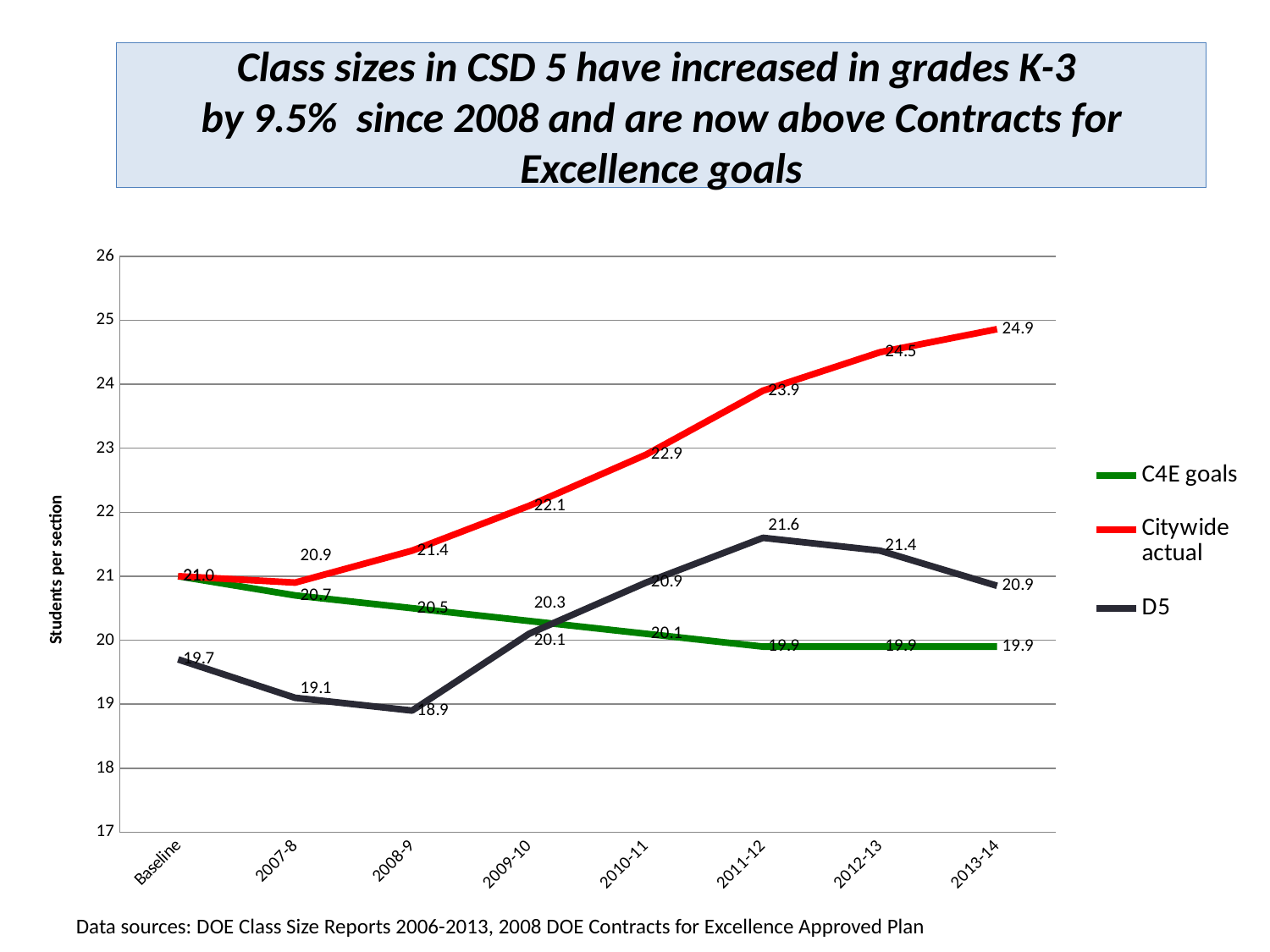
Does the C4E goals series rise or fall from Baseline to 2013-14? fall What is the difference between the Citywide actual and D5 values in 2013-14? 4.0 How many time points are plotted on the x axis? 8 Which is larger in 2012-13, the D5 value or the C4E goals value? D5 What is the Citywide actual value for 2013-14? 24.9 What is the D5 value for 2011-12? 21.6 In which year is the D5 series at its lowest? 2008-9 How many series does the legend list? 3 What kind of chart is shown on the slide? line chart In which year is the Citywide actual series at its highest? 2013-14 Is the D5 value for 2008-9 greater or less than 19? less What is the C4E goals value for 2009-10? 20.3